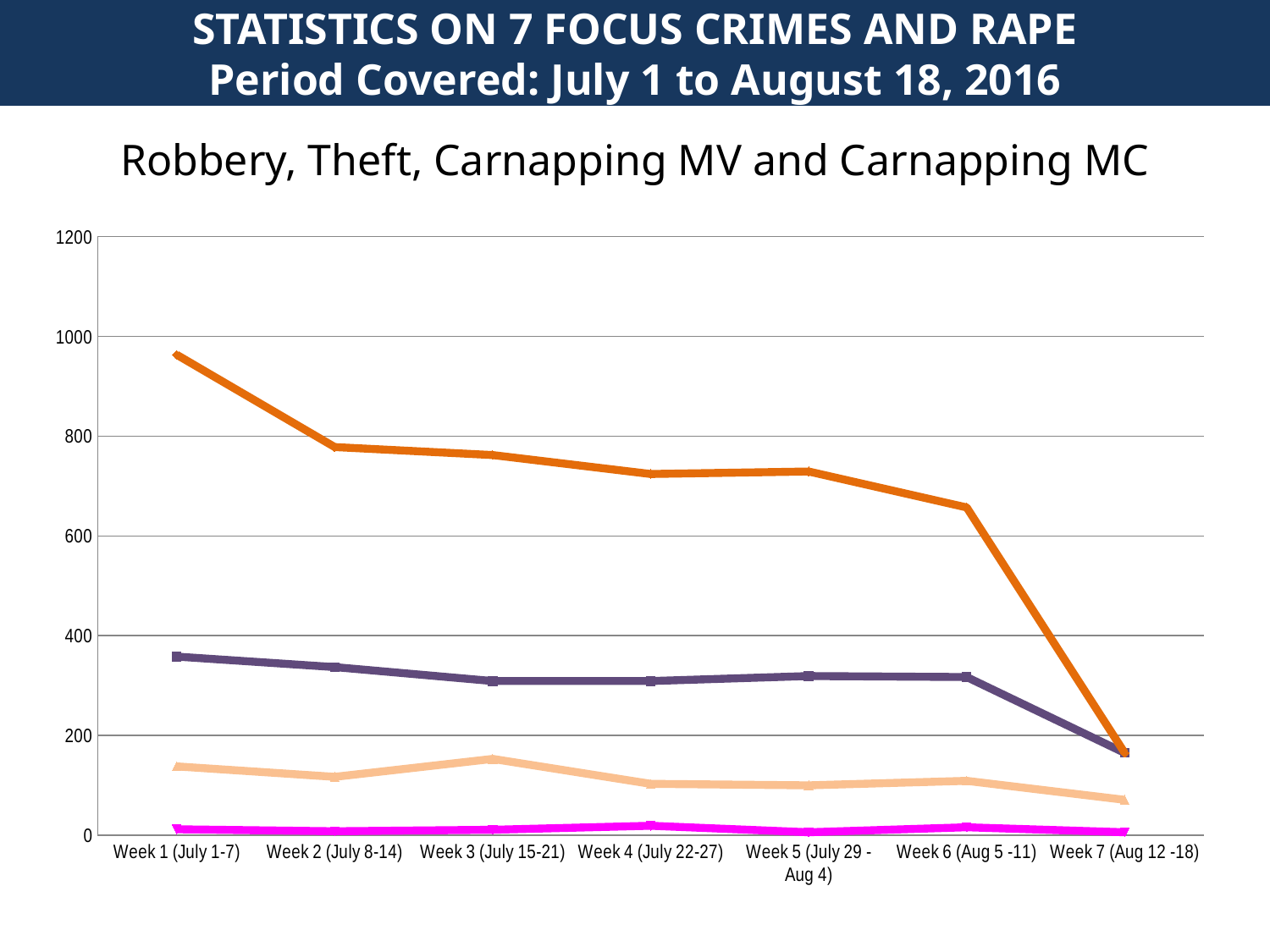
Is the value of the orange line at Week 7 (Aug 12-18) greater or less than 400? less In which week does the orange line reach its highest value? Week 1 (July 1-7) Is the value of the dark purple line at Week 1 (July 1-7) greater or less than 200? greater In which week does the orange line reach its lowest value? Week 7 (Aug 12-18) Is the value of the light orange line at Week 3 (July 15-21) greater or less than 200? less What kind of chart is shown on the slide? line chart Does the orange line rise or fall from Week 1 to Week 7? fall At Week 1 (July 1-7), which is larger: the orange line or the dark purple line? the orange line How many weeks are shown along the x axis of the chart? 7 How many lines are plotted on the chart? 4 What is the highest value shown on the vertical axis of the chart? 1200